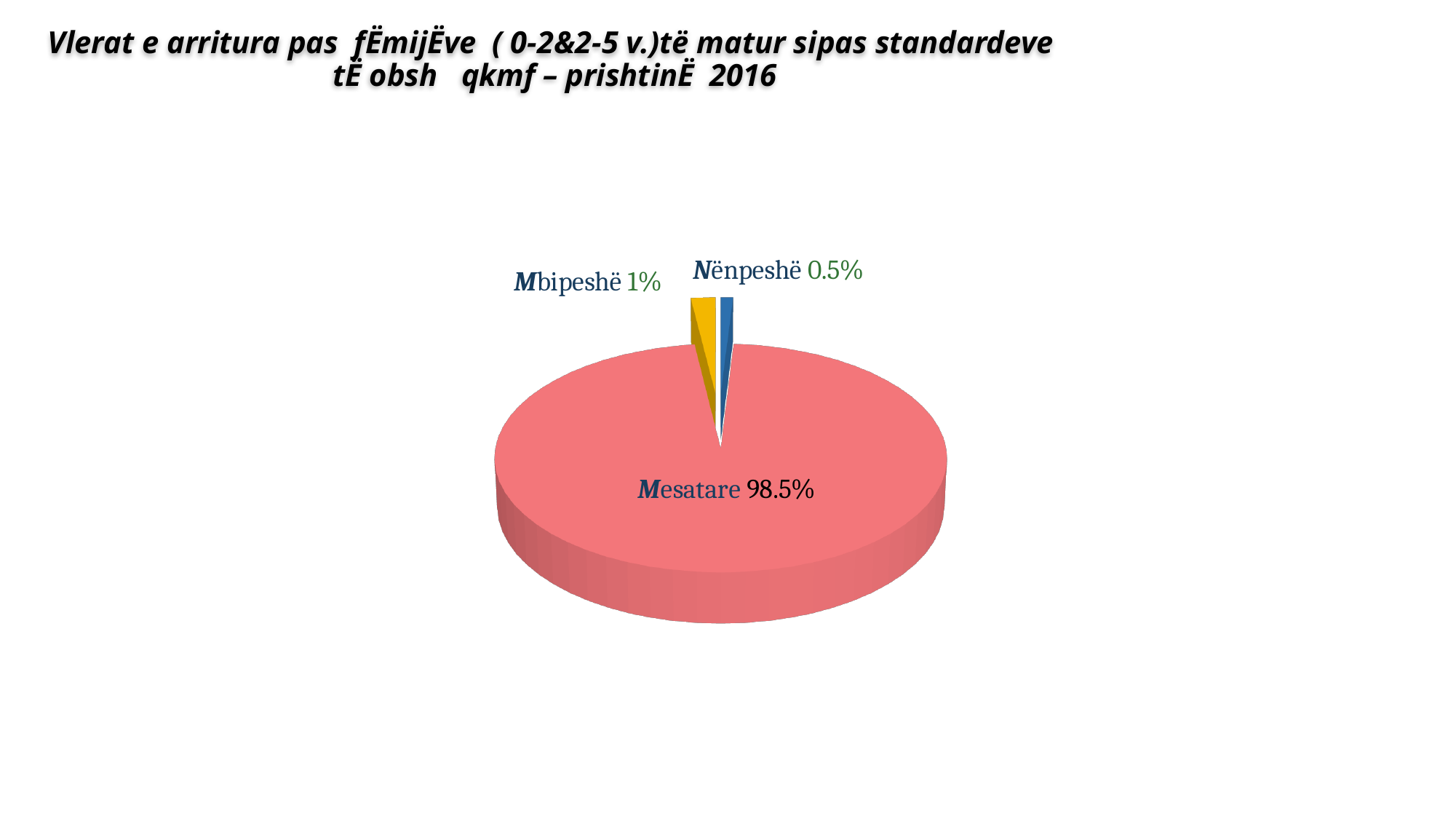
How many slices does the pie chart have? 3 What is the difference between the share for Mbipeshë and the share for Nënpeshë? 0.5% What colour is the Mbipeshë slice of the pie? yellow What share of the pie does Nënpeshë have? 0.5% What share of the pie does Mesatare have? 98.5% Which category has the smallest slice of the pie? Nënpeshë What share of the pie does Mbipeshë have? 1% What is the difference between the share for Mesatare and the share for Mbipeshë? 97.5% Which is larger, the share for Mbipeshë or the share for Nënpeshë? Mbipeshë What colour is the Mesatare slice of the pie? red (pink) Which category has the largest slice of the pie? Mesatare What kind of chart is shown on the slide? pie chart